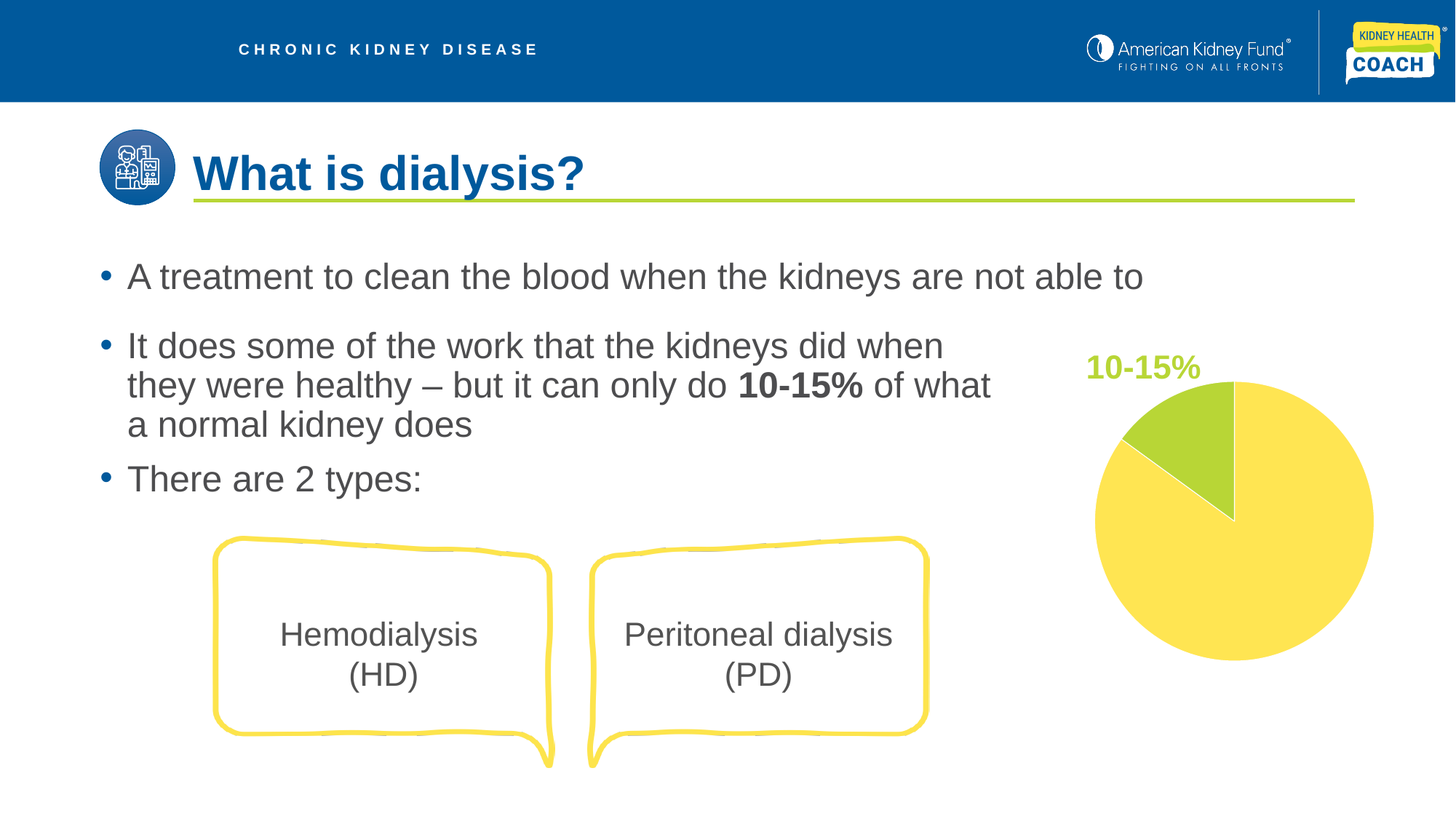
How many slices does the pie chart have? 2 What label is printed next to the green slice of the pie chart? 10-15% Which slice of the pie chart is the largest? the yellow slice Which slice of the pie chart is the smallest? the green slice What kind of chart is shown on the right side of the slide? pie chart What share of the pie does the green slice represent, according to its label? 10-15% What colour is the slice of the pie chart labelled 10-15%? green Which slice of the pie chart is larger, the yellow slice or the green slice? the yellow slice What colour is the unlabelled, larger slice of the pie chart? yellow